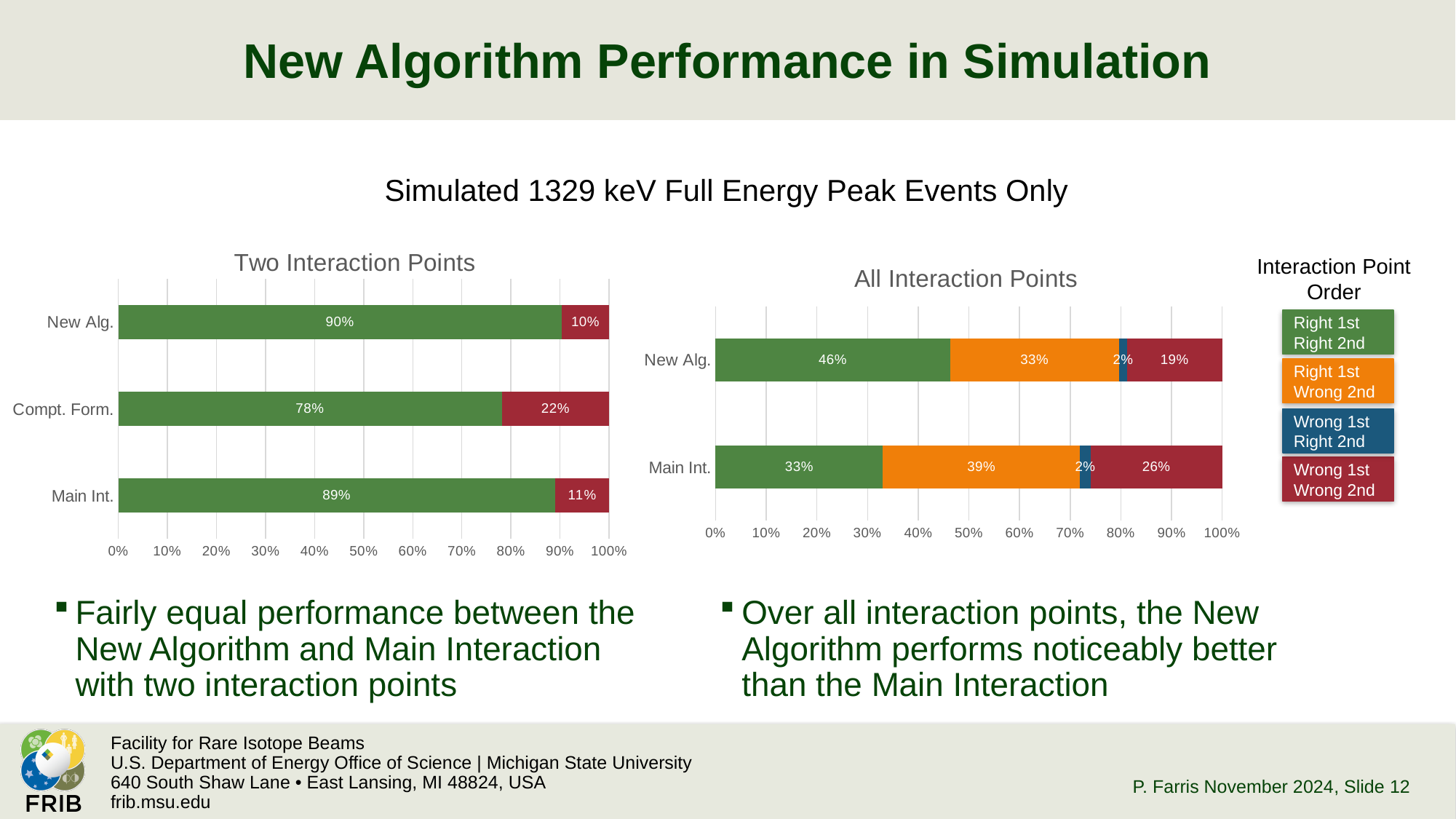
In the "Two Interaction Points" chart, what is the "Wrong 1st Wrong 2nd" value for New Alg.? 10% What type of chart is the "All Interaction Points" chart? Stacked bar chart In the "Two Interaction Points" chart, which category has the lowest "Right 1st Right 2nd" value? Compt. Form. In the "All Interaction Points" chart, what is the "Wrong 1st Right 2nd" value for Main Int.? 2% In the "All Interaction Points" chart, which category has the higher "Right 1st Right 2nd" value, New Alg. or Main Int.? New Alg. In the "All Interaction Points" chart, what is the difference between the "Wrong 1st Wrong 2nd" values for Main Int. and New Alg.? 7% In the "All Interaction Points" chart, what is the "Wrong 1st Wrong 2nd" value for New Alg.? 19% In the "Two Interaction Points" chart, what is the "Right 1st Right 2nd" value for Compt. Form.? 78% In the "Two Interaction Points" chart, how many categories are shown? 3 In the "Two Interaction Points" chart, what is the difference between the "Right 1st Right 2nd" values for New Alg. and Compt. Form.? 12% How many entries does the "Interaction Point Order" legend list? 4 In the "All Interaction Points" chart, what is the "Right 1st Wrong 2nd" value for Main Int.? 39%